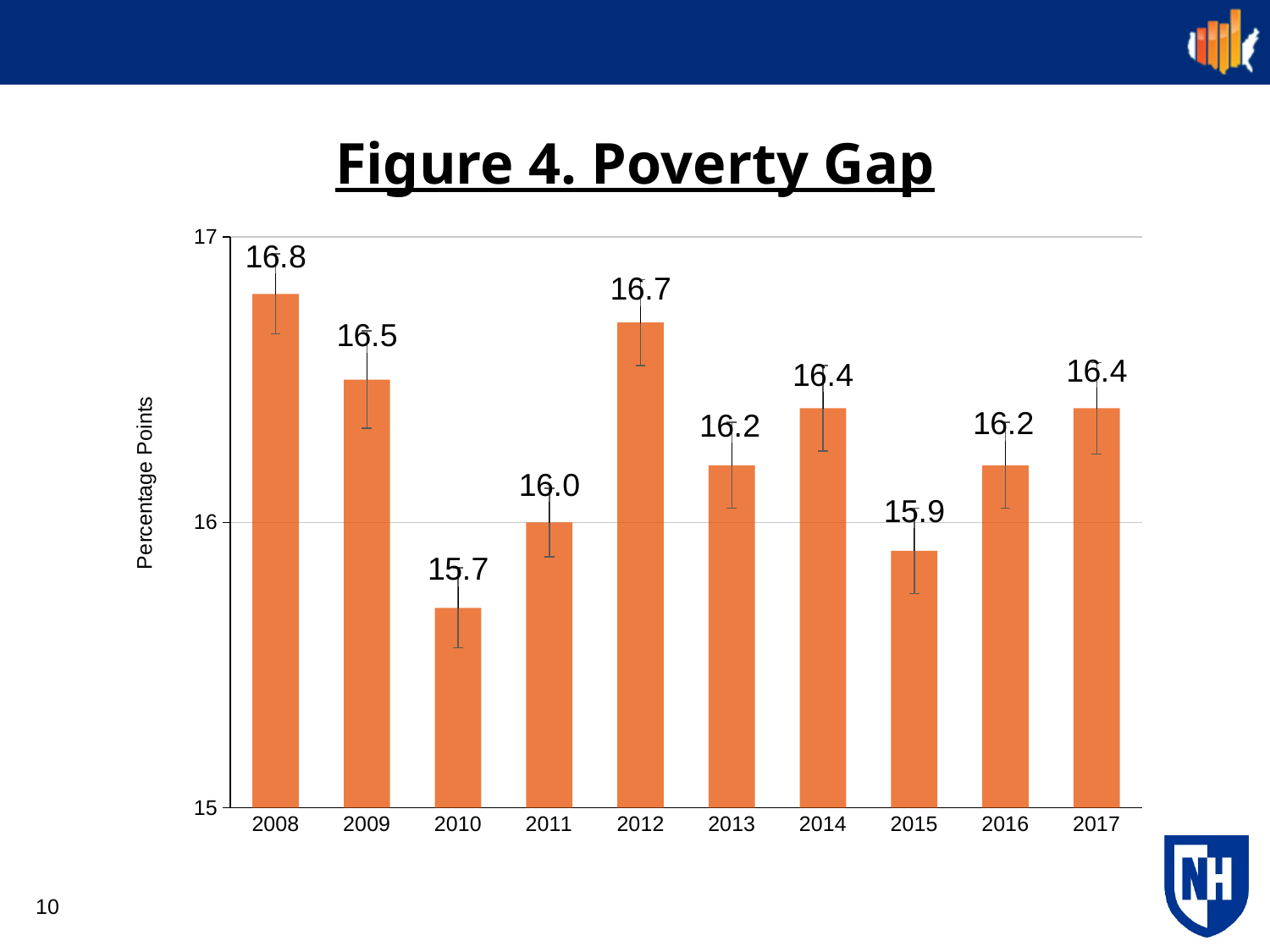
What is the poverty gap value for 2011? 16.0 What is the difference between the poverty gap in 2012 and in 2013? 0.5 What is the poverty gap value for 2008? 16.8 How many years are shown on the x axis? 10 Which year has a larger poverty gap, 2009 or 2014? 2009 What is the poverty gap value for 2015? 15.9 What is the label of the y axis? Percentage Points Which year has the highest poverty gap? 2008 Which year has the lowest poverty gap? 2010 What is the difference between the poverty gap in 2008 and in 2010? 1.1 What kind of chart is shown on the slide? bar chart Is the poverty gap value for 2010 greater or less than 16? less